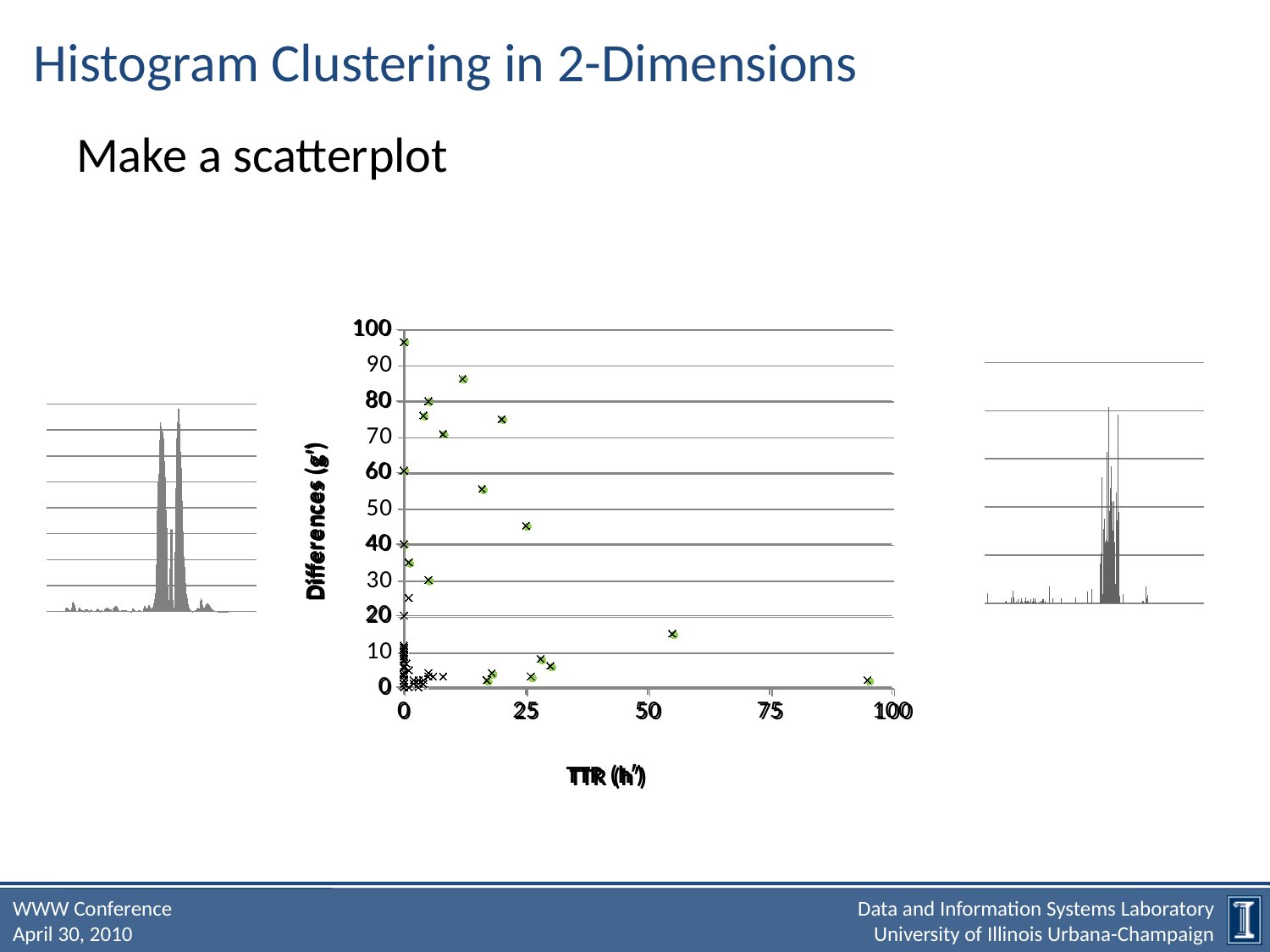
What is the highest tick value shown on the x axis of the central scatter plot? 100 In the central scatter plot, is the TTR value of the rightmost point greater or less than 75? greater In the central scatter plot, which has the larger Differences value: the point near TTR 55 or the point near TTR 95? the point near TTR 55 What kind of chart is the central chart on the slide? scatter plot What is the label of the y axis of the central scatter plot? Differences (g') In the central scatter plot, is the Differences value of the point plotted near TTR 25 greater or less than 40? greater In the central scatter plot, is the Differences value of the point plotted near TTR 55 greater or less than 10? greater What is the label of the x axis of the central scatter plot? TTR (h')